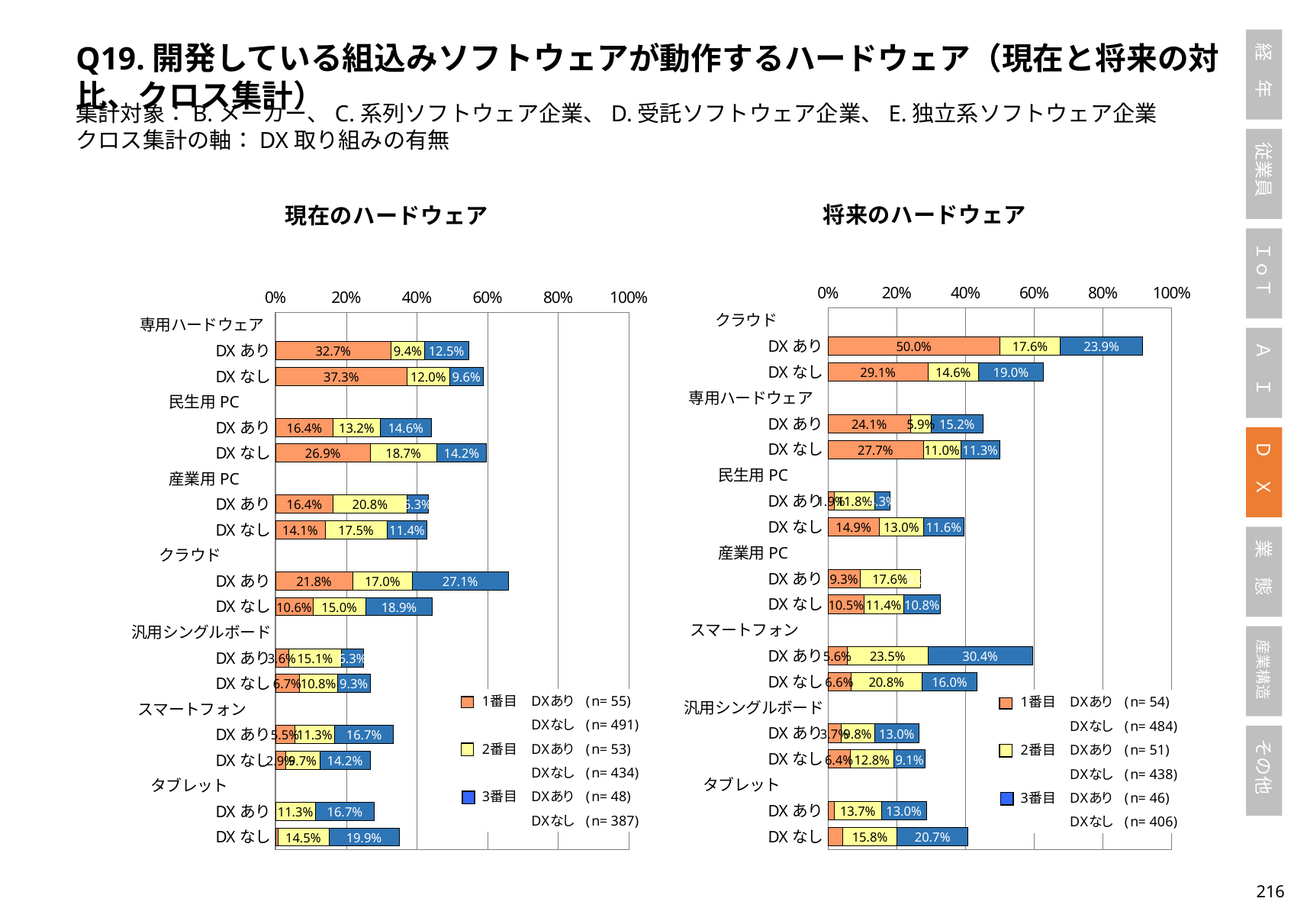
In the 現在のハードウェア chart, what is the difference between the 1番目 values for 専用ハードウェア DX なし and 専用ハードウェア DX あり? 4.6% What kind of chart is used for 現在のハードウェア? stacked bar chart In the 現在のハードウェア chart, is the total length of the クラウド DX あり bar greater or less than 60%? greater In the 将来のハードウェア chart, what is the total of the stacked bar for クラウド DX あり? 91.5% In the 将来のハードウェア chart, what is the 3番目 value for スマートフォン DX あり? 30.4% In the 現在のハードウェア chart, what is the 3番目 value for クラウド DX あり? 27.1% In the 将来のハードウェア chart, which bar has the largest 1番目 segment? クラウド DX あり In the 将来のハードウェア chart, what is the n for DXなし in the 1番目 series shown in the legend? 484 In the 将来のハードウェア chart, which is larger: the 3番目 value for クラウド DX あり or for クラウド DX なし? クラウド DX あり How many series does the legend of the 将来のハードウェア chart list? 3 In the 現在のハードウェア chart, what is the 1番目 value for 専用ハードウェア DX あり? 32.7% In the 将来のハードウェア chart, what is the 1番目 value for クラウド DX あり? 50.0%